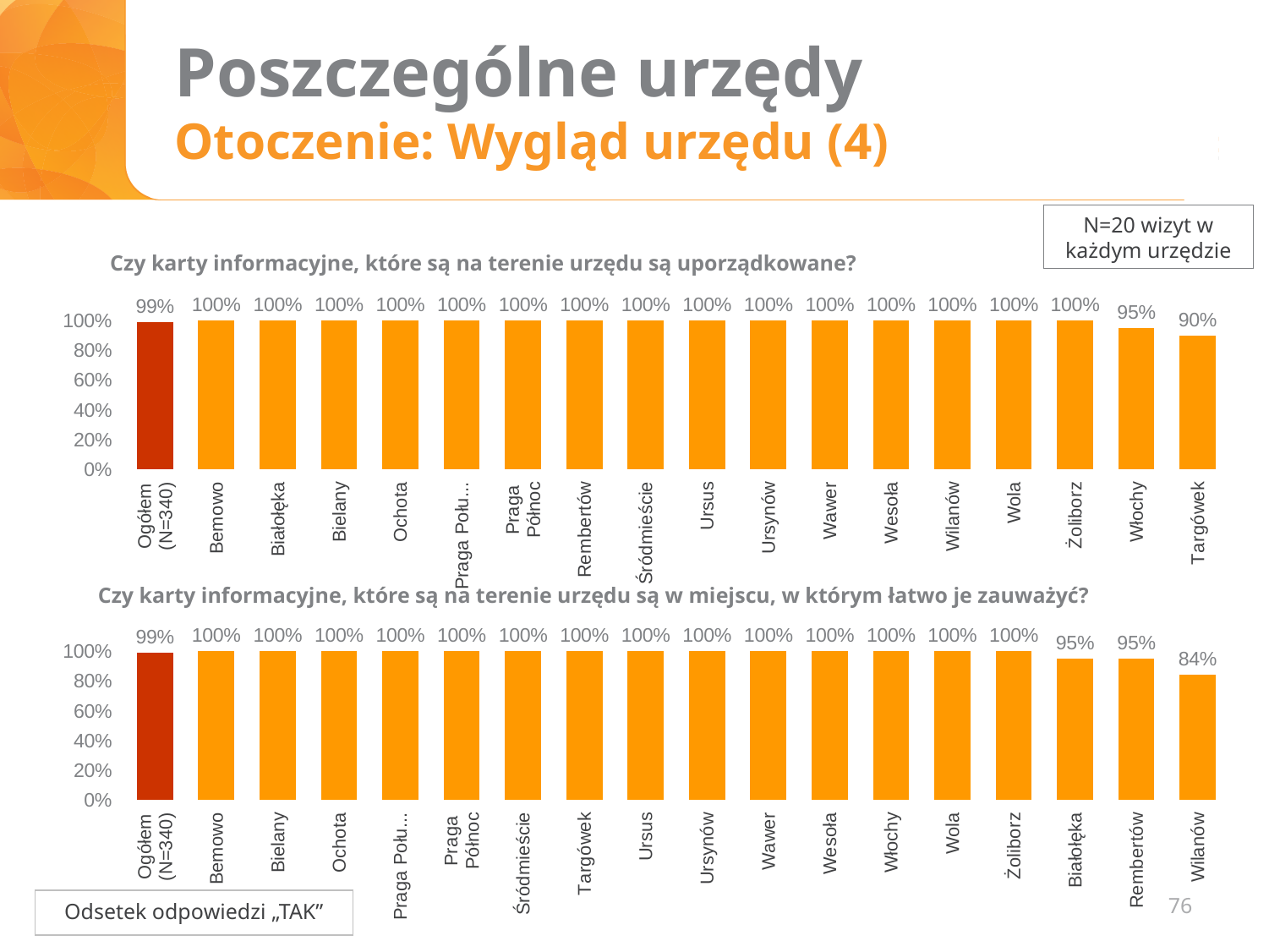
In the bottom chart ("Czy karty informacyjne, które są na terenie urzędu są w miejscu, w którym łatwo je zauważyć?"), which is larger, the value for Białołęka or the value for Wilanów? Białołęka In the top chart ("Czy karty informacyjne, które są na terenie urzędu są uporządkowane?"), what is the value for Targówek? 90% In the bottom chart ("Czy karty informacyjne, które są na terenie urzędu są w miejscu, w którym łatwo je zauważyć?"), which category has the lowest value? Wilanów In the top chart ("Czy karty informacyjne, które są na terenie urzędu są uporządkowane?"), what is the difference between the values for Włochy and Targówek? 5% In the top chart ("Czy karty informacyjne, które są na terenie urzędu są uporządkowane?"), what is the value for Ogółem (N=340)? 99% How many categories are shown in the top chart ("Czy karty informacyjne, które są na terenie urzędu są uporządkowane?")? 18 What type of chart is the bottom chart ("Czy karty informacyjne, które są na terenie urzędu są w miejscu, w którym łatwo je zauważyć?")? Bar chart In the bottom chart ("Czy karty informacyjne, które są na terenie urzędu są w miejscu, w którym łatwo je zauważyć?"), what is the difference between the values for Bemowo and Wilanów? 16% In the bottom chart ("Czy karty informacyjne, które są na terenie urzędu są w miejscu, w którym łatwo je zauważyć?"), what is the value for Rembertów? 95% In the top chart ("Czy karty informacyjne, które są na terenie urzędu są uporządkowane?"), which category has the lowest value? Targówek In the top chart ("Czy karty informacyjne, które są na terenie urzędu są uporządkowane?"), what is the value for Włochy? 95% In the bottom chart ("Czy karty informacyjne, które są na terenie urzędu są w miejscu, w którym łatwo je zauważyć?"), what is the value for Wilanów? 84%